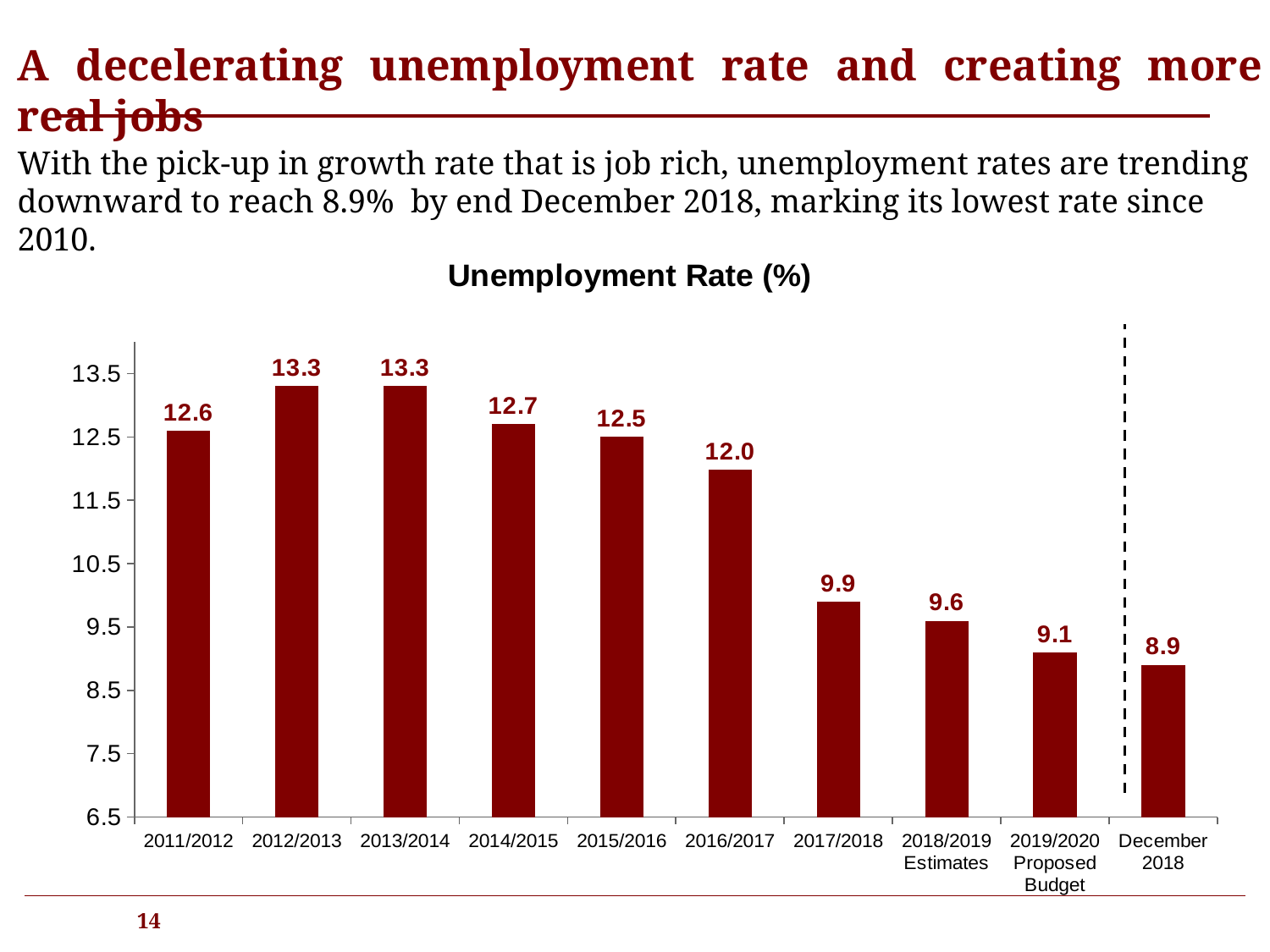
What is the unemployment rate for 2019/2020 Proposed Budget? 9.1 How many bars are shown in the chart? 10 What is the difference between the unemployment rate in 2018/2019 Estimates and December 2018? 0.7 Which category has the lowest unemployment rate? December 2018 Do the unemployment rates generally rise or fall from 2013/2014 to December 2018? Fall What is the unemployment rate shown for December 2018? 8.9 What kind of chart is shown on the slide? Bar chart What is the unemployment rate for 2016/2017? 12.0 Which is larger, the unemployment rate for 2014/2015 or for 2015/2016? 2014/2015 What is the difference between the unemployment rate in 2012/2013 and in 2017/2018? 3.4 What is the unemployment rate for 2011/2012? 12.6 Is the unemployment rate for 2017/2018 greater or less than 10.5? less